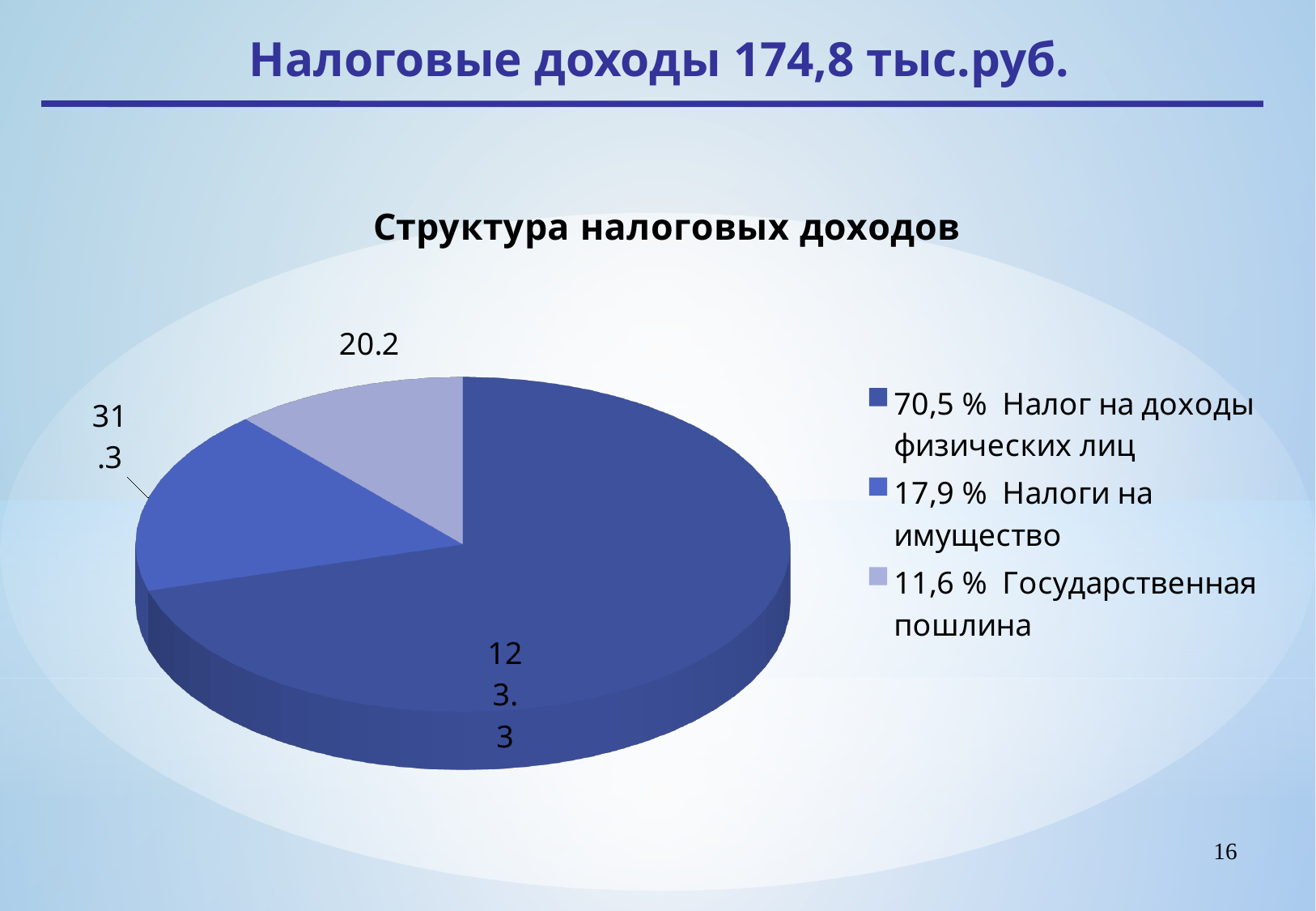
What share of the pie does Налог на доходы физических лиц account for, according to the legend? 70,5 % Which is larger: the slice for Налоги на имущество or the slice for Государственная пошлина? Налоги на имущество What kind of chart is shown on the slide? pie chart What value is labelled on the slice for Государственная пошлина? 20.2 Which category has the smallest slice of the pie? Государственная пошлина What is the difference between the labelled values for Налоги на имущество and Государственная пошлина? 11.1 Which category has the largest slice of the pie? Налог на доходы физических лиц What is the title of the chart? Структура налоговых доходов What value is labelled on the slice for Налоги на имущество? 31.3 How many slices does the pie chart have? 3 What value is labelled on the slice for Налог на доходы физических лиц? 123.3 What share of the pie does Государственная пошлина account for, according to the legend? 11,6 %